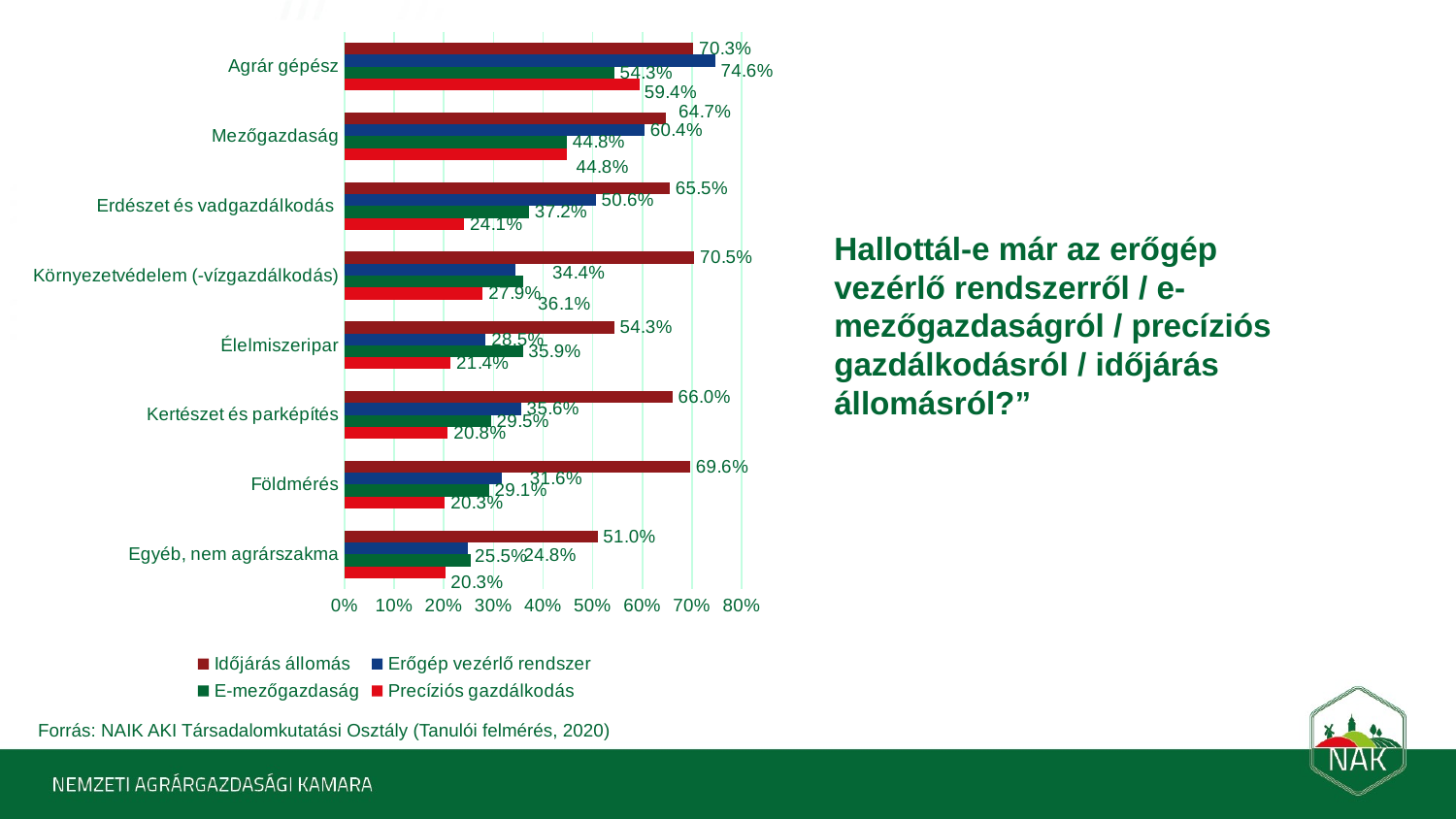
How many categories are shown on the chart? 8 Which category has the lowest value for Időjárás állomás? Egyéb, nem agrárszakma What is the value of Erőgép vezérlő rendszer for Agrár gépész? 74.6% What is the value of Időjárás állomás for Agrár gépész? 70.3% What kind of chart is shown on the slide? Bar chart What colour represents Időjárás állomás in the legend? Dark red For Mezőgazdaság, which is larger: Időjárás állomás or Erőgép vezérlő rendszer? Időjárás állomás For Agrár gépész, what is the difference between the Erőgép vezérlő rendszer value and the Időjárás állomás value? 4.3 percentage points Which category has the highest value for Erőgép vezérlő rendszer? Agrár gépész What is the value of Precíziós gazdálkodás for Erdészet és vadgazdálkodás? 24.1% What is the value of Időjárás állomás for Egyéb, nem agrárszakma? 51.0% How many series does the legend list? 4